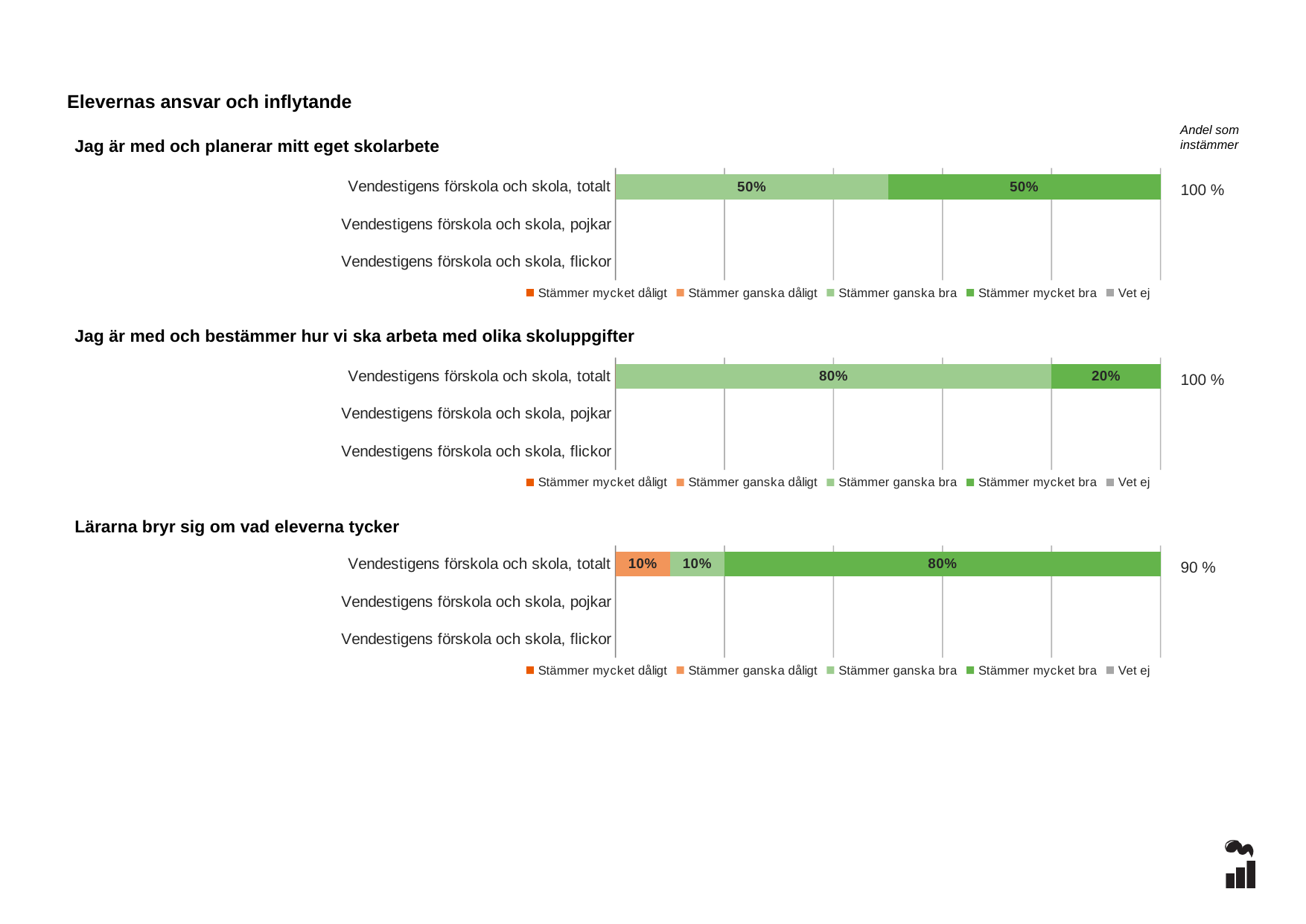
What is the 'Andel som instämmer' shown for the chart 'Lärarna bryr sig om vad eleverna tycker'? 90 % In the chart 'Jag är med och planerar mitt eget skolarbete', what is the value for 'Stämmer mycket bra' for Vendestigens förskola och skola, totalt? 50% In the chart 'Lärarna bryr sig om vad eleverna tycker', what is the value for 'Stämmer mycket bra' for Vendestigens förskola och skola, totalt? 80% In the chart 'Jag är med och bestämmer hur vi ska arbeta med olika skoluppgifter', which is larger for the totalt row: 'Stämmer ganska bra' or 'Stämmer mycket bra'? Stämmer ganska bra How many series does the legend list in the chart 'Jag är med och planerar mitt eget skolarbete'? 5 How many category rows are listed on the y axis of the chart 'Jag är med och planerar mitt eget skolarbete'? 3 In the chart 'Jag är med och bestämmer hur vi ska arbeta med olika skoluppgifter', what is the difference between 'Stämmer ganska bra' and 'Stämmer mycket bra' for the totalt row? 60% In the chart 'Jag är med och bestämmer hur vi ska arbeta med olika skoluppgifter', what is the value for 'Stämmer mycket bra' for Vendestigens förskola och skola, totalt? 20% What kind of chart is 'Lärarna bryr sig om vad eleverna tycker'? Stacked horizontal bar chart In the chart 'Jag är med och bestämmer hur vi ska arbeta med olika skoluppgifter', what is the value for 'Stämmer ganska bra' for Vendestigens förskola och skola, totalt? 80% In the chart 'Lärarna bryr sig om vad eleverna tycker', what is the value for 'Stämmer ganska dåligt' for Vendestigens förskola och skola, totalt? 10% In the chart 'Lärarna bryr sig om vad eleverna tycker', which response category has the largest share for Vendestigens förskola och skola, totalt? Stämmer mycket bra